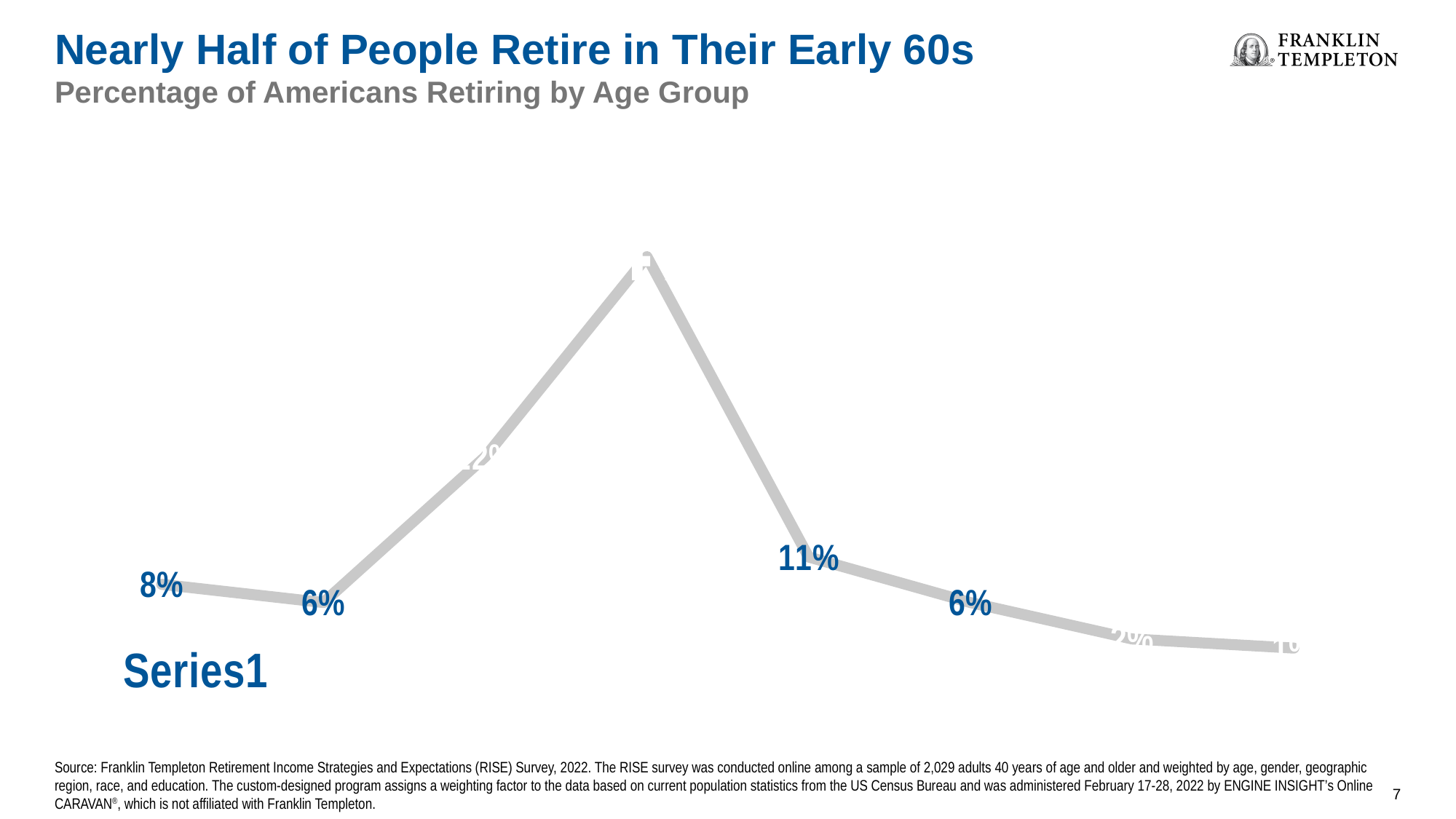
What is the main title of the slide? Nearly Half of People Retire in Their Early 60s What is the value of the fifth point from the left on the line? 11% Which point on the line is the highest: the first, third or fourth from the left? fourth What is the value of the first (leftmost) point on the line? 8% What kind of chart is shown on the slide? line chart What is the subtitle describing the chart? Percentage of Americans Retiring by Age Group Do the values rise or fall from the fourth point to the last point on the line? fall What is the value of the second point from the left on the line? 6% How many data points are plotted on the line? 8 Which is larger, the value of the first point (8%) or the second point (6%)? the first point (8%)